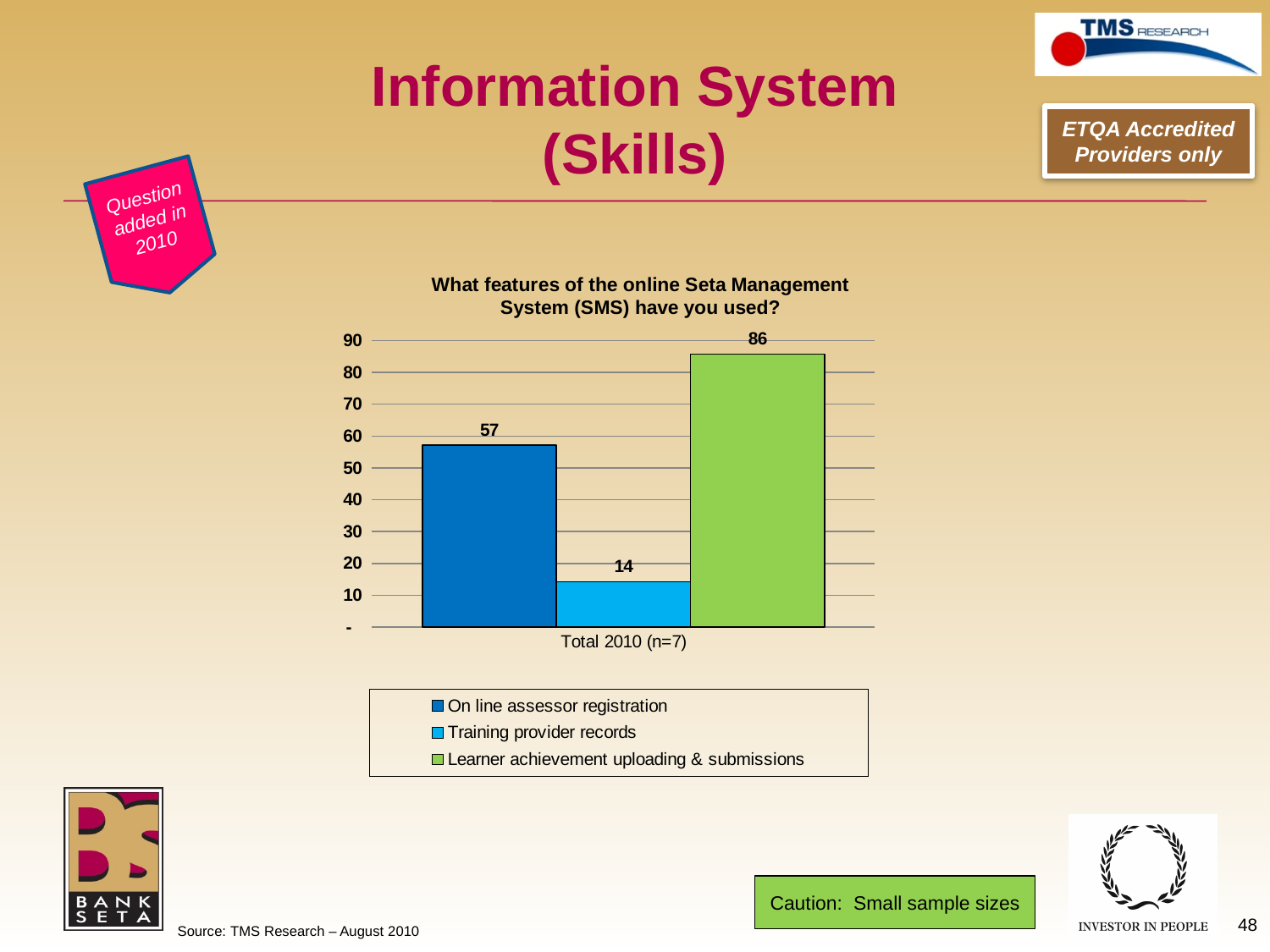
What is the x-axis category label shown under the bars? Total 2010 (n=7) Which is larger, the value for On line assessor registration or the value for Training provider records? On line assessor registration What is the value for Learner achievement uploading & submissions? 86 How many series does the legend list? 3 What is the difference between the values for Learner achievement uploading & submissions and On line assessor registration? 29 Which series has the lowest value? Training provider records What kind of chart is shown on the slide? Bar chart What is the value for Training provider records? 14 What is the difference between the values for On line assessor registration and Training provider records? 43 What is the value for On line assessor registration? 57 Which series has the highest value? Learner achievement uploading & submissions Is the value for Learner achievement uploading & submissions greater or less than 80? greater